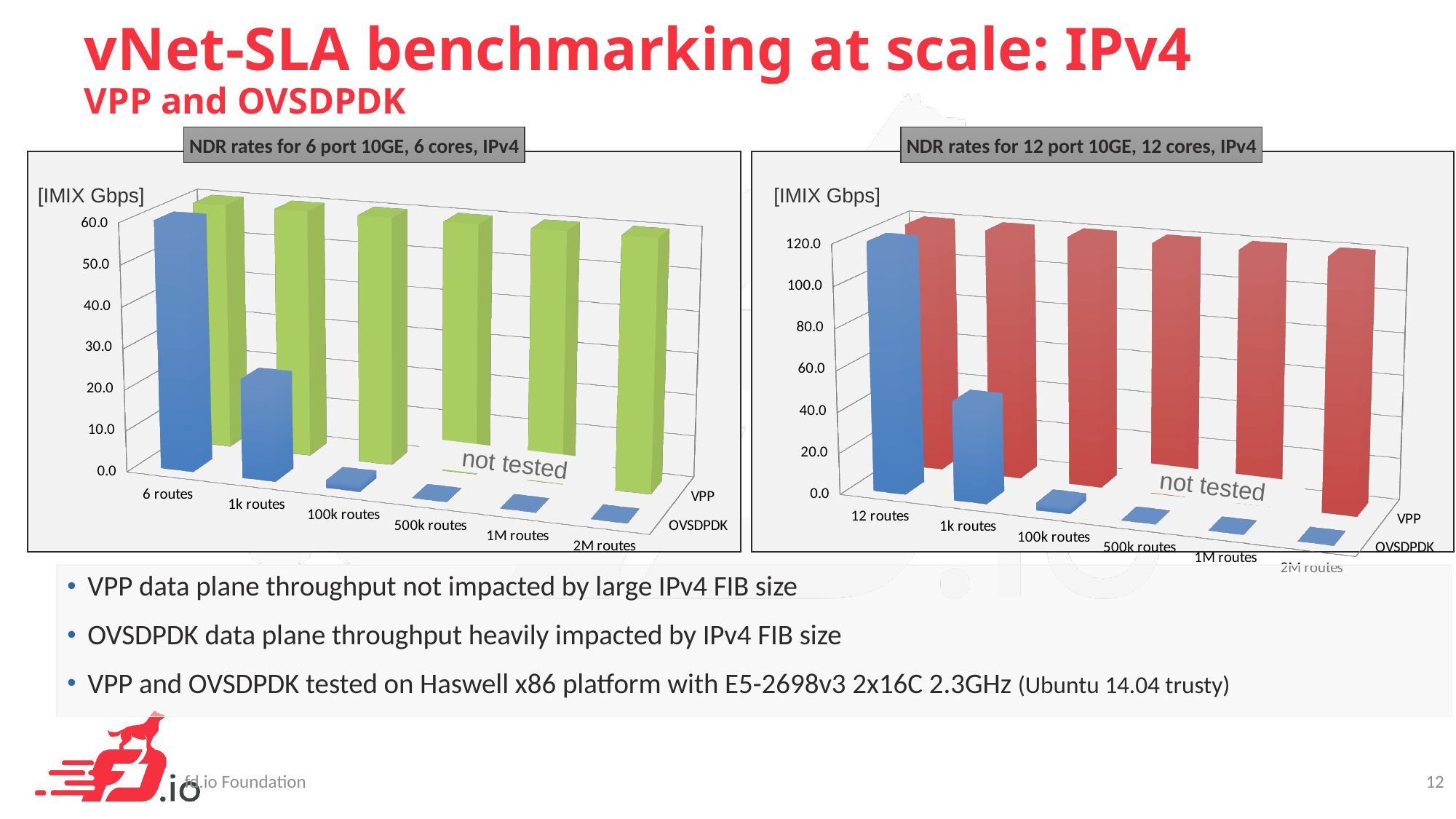
In the right chart, 'NDR rates for 12 port 10GE, 12 cores, IPv4', do the OVSDPDK values rise or fall as the number of routes increases? fall What unit label is shown on the vertical axis of the left chart, 'NDR rates for 6 port 10GE, 6 cores, IPv4'? [IMIX Gbps] How many series does the right chart, 'NDR rates for 12 port 10GE, 12 cores, IPv4', plot? 2 In the left chart, 'NDR rates for 6 port 10GE, 6 cores, IPv4', is the OVSDPDK value for 6 routes greater or less than 50.0? greater In the right chart, 'NDR rates for 12 port 10GE, 12 cores, IPv4', is the VPP value for 12 routes greater or less than 100.0? greater In the right chart, 'NDR rates for 12 port 10GE, 12 cores, IPv4', at which route count is the OVSDPDK value highest? 12 routes In the left chart, 'NDR rates for 6 port 10GE, 6 cores, IPv4', which is larger at 1k routes: VPP or OVSDPDK? VPP In the left chart, 'NDR rates for 6 port 10GE, 6 cores, IPv4', is the OVSDPDK value for 1k routes greater or less than 30.0? less How many route-count categories does the left chart, 'NDR rates for 6 port 10GE, 6 cores, IPv4', show? 6 What kind of chart is the left chart, 'NDR rates for 6 port 10GE, 6 cores, IPv4'? bar chart